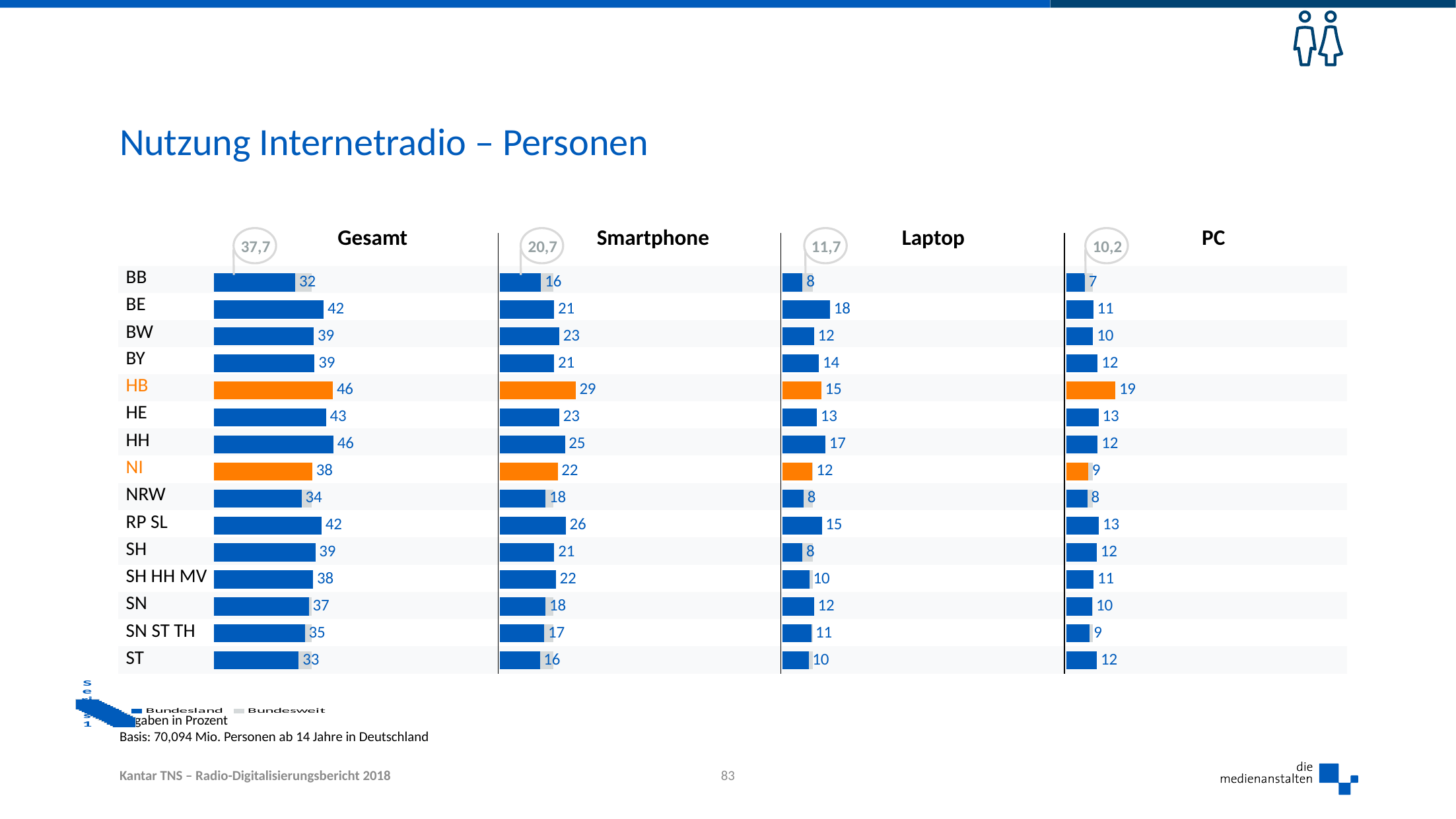
In the PC chart, which is larger, the value for HE or the value for SN? HE In the Gesamt chart, what is the difference between the values for HB and NRW? 12 In the PC chart, which category has the lowest value? BB How many categories are listed in the Laptop chart? 15 In the PC chart, what is the value for NI? 9 In the Smartphone chart, which category has the highest value? HB In the Laptop chart, what is the value for HH? 17 In the Laptop chart, which category has the highest value? BE In the Smartphone chart, what is the value for RP SL? 26 What is the Bundesweit value shown for the Smartphone chart? 20,7 In the Gesamt chart, which category has the lowest value? BB In the Gesamt chart, what is the value for HE? 43